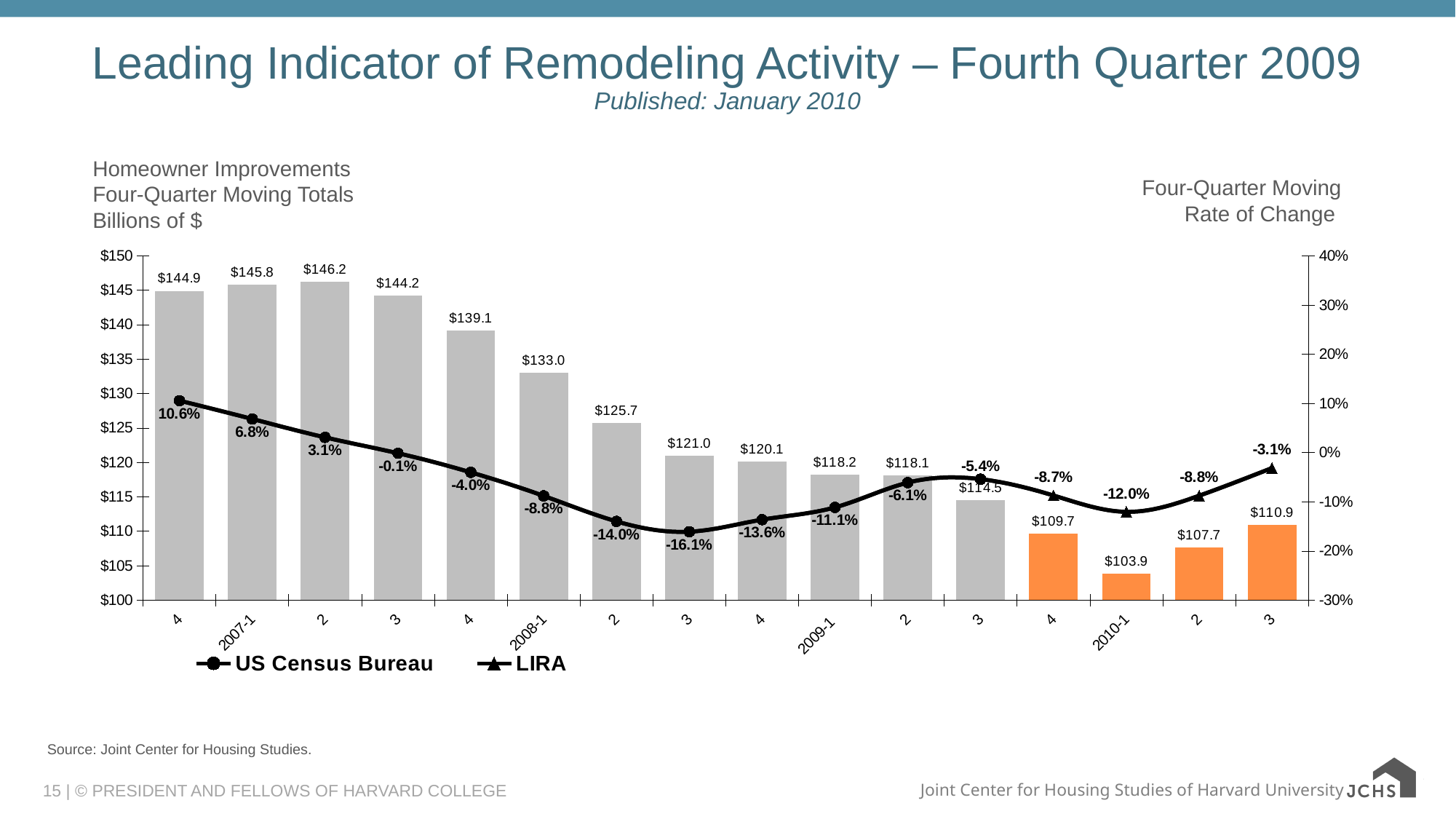
Which is larger, the four-quarter moving total for 2009-1 or for 2010-1? 2009-1 What is the four-quarter moving rate of change shown for 2009-1? -11.1% What is the four-quarter moving total for 2007-1? $145.8 How many bars are plotted in the chart? 16 Which quarter has the highest four-quarter moving total bar? 2007 quarter 2 ($146.2) Which quarter has the lowest four-quarter moving total bar? 2010-1 ($103.9) How many series does the legend list? 2 What is the difference between the four-quarter moving totals for 2008-1 and 2009-1? $14.8 What are the two series named in the legend? US Census Bureau and LIRA What is the LIRA rate of change shown for the last point (2010 quarter 3)? -3.1% What kind of chart is this? Combined bar and line chart What is the four-quarter moving total for 2010-1? $103.9